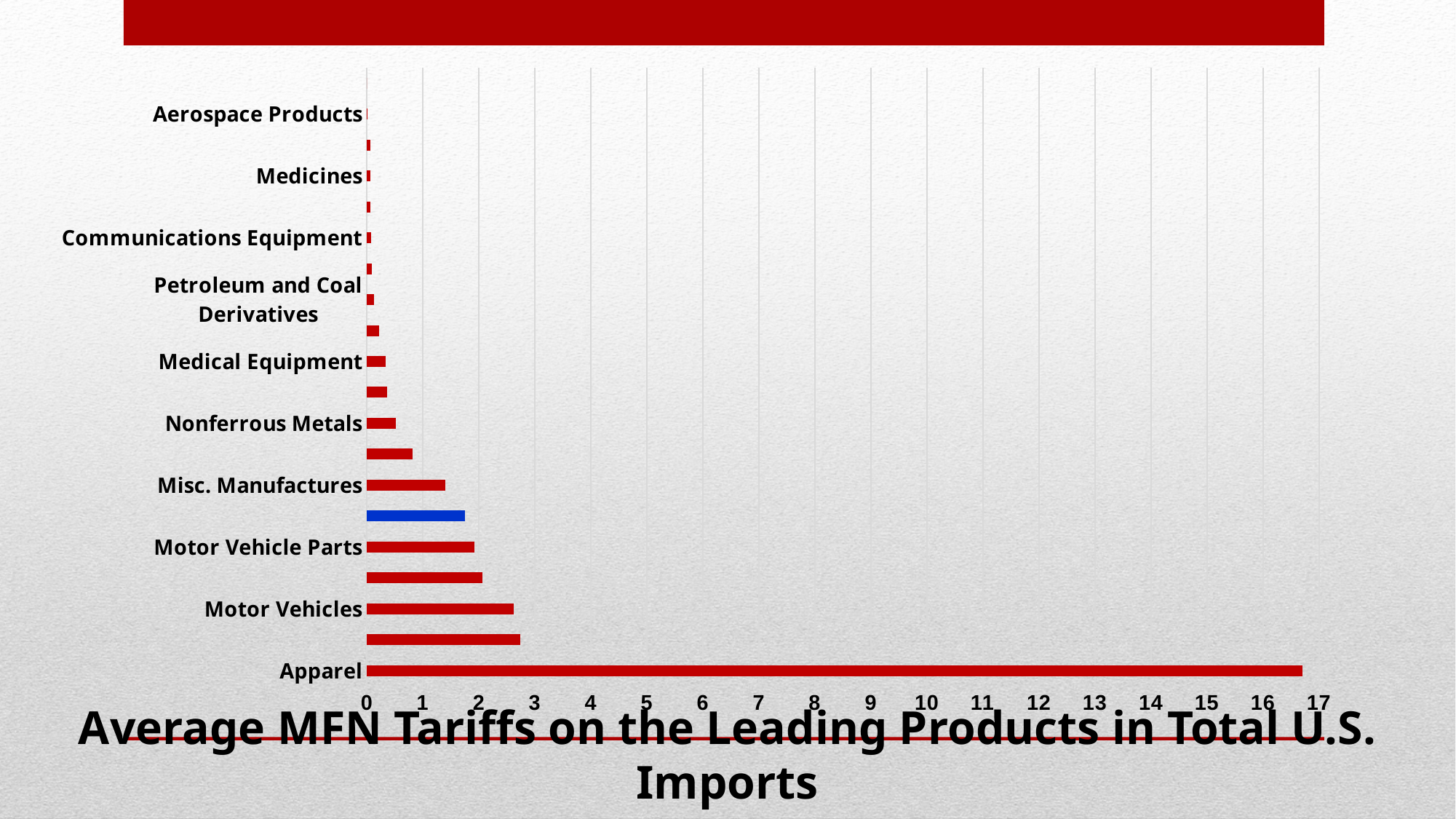
Is the value for Medical Equipment greater or less than 1? less Is the value for Motor Vehicles greater or less than 2? greater Which labelled product has the highest average MFN tariff? Apparel What colour are most of the bars in the chart? red Which has the larger value, Motor Vehicles or Misc. Manufactures? Motor Vehicles What kind of chart is shown on the slide? bar chart Is the value for Apparel greater or less than 16? greater Which has the larger value, Apparel or Motor Vehicles? Apparel What is the title of the chart? Average MFN Tariffs on the Leading Products in Total U.S. Imports